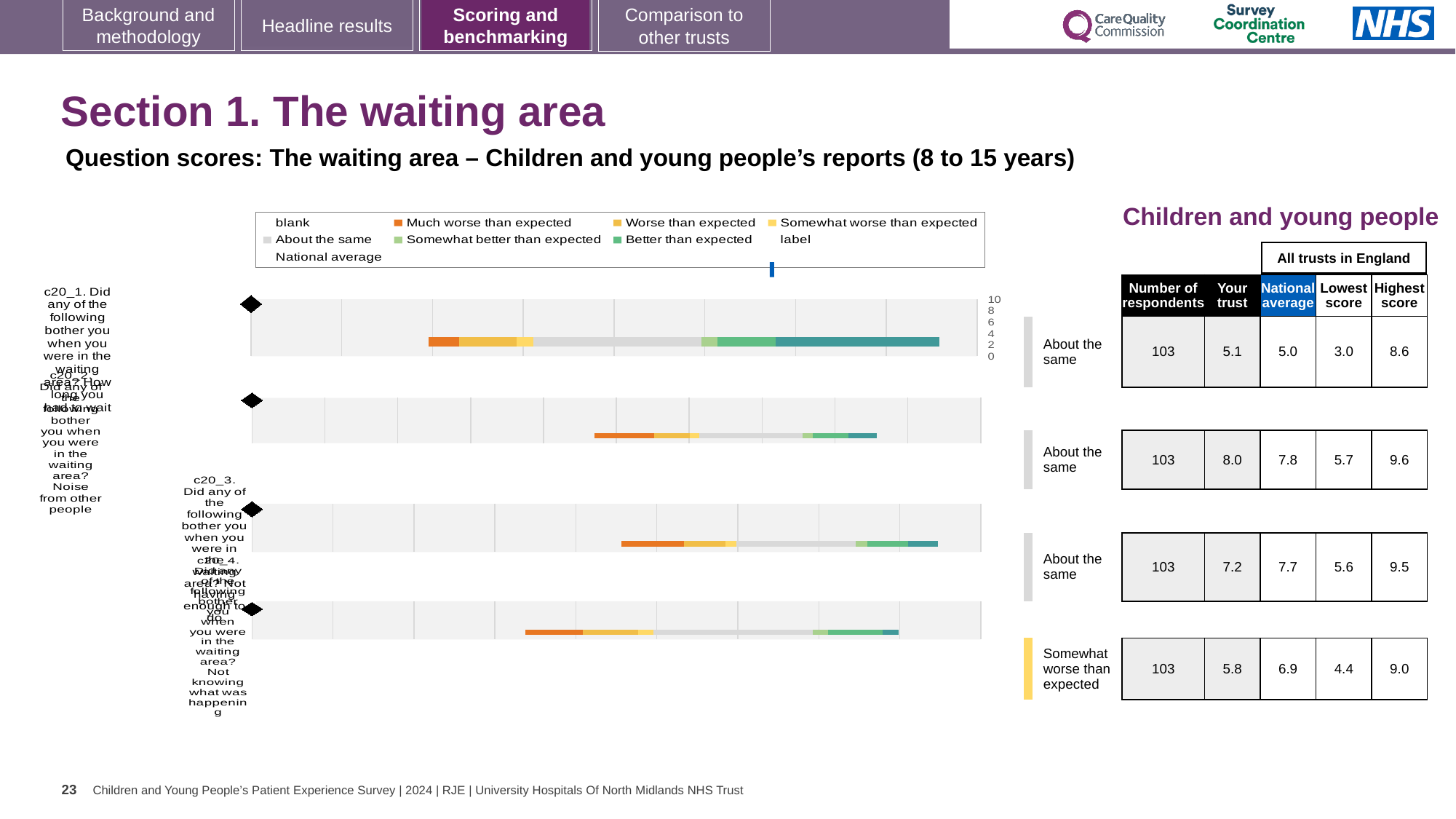
What is the national average for the second question row? 7.8 What kind of chart is shown on the slide? bar chart What is the maximum value shown on the chart's numeric axis? 10 What is the 'Your trust' score for the first question row (c20_1)? 5.1 What is the difference between the 'Your trust' score and the national average for the second question row? 0.2 Which question row has the lowest 'Your trust' score? the first row (5.1) How many horizontal bars are plotted in the chart? 4 Which legend entry is shown in orange? Much worse than expected For the fourth question row, is the 'Your trust' score or the national average larger? national average What is the highest score across all trusts in England for the third question row (c20_3)? 9.5 Which question row has the highest 'Your trust' score? the second row (8.0) What is the lowest score across all trusts in England for the fourth question row (c20_4)? 4.4